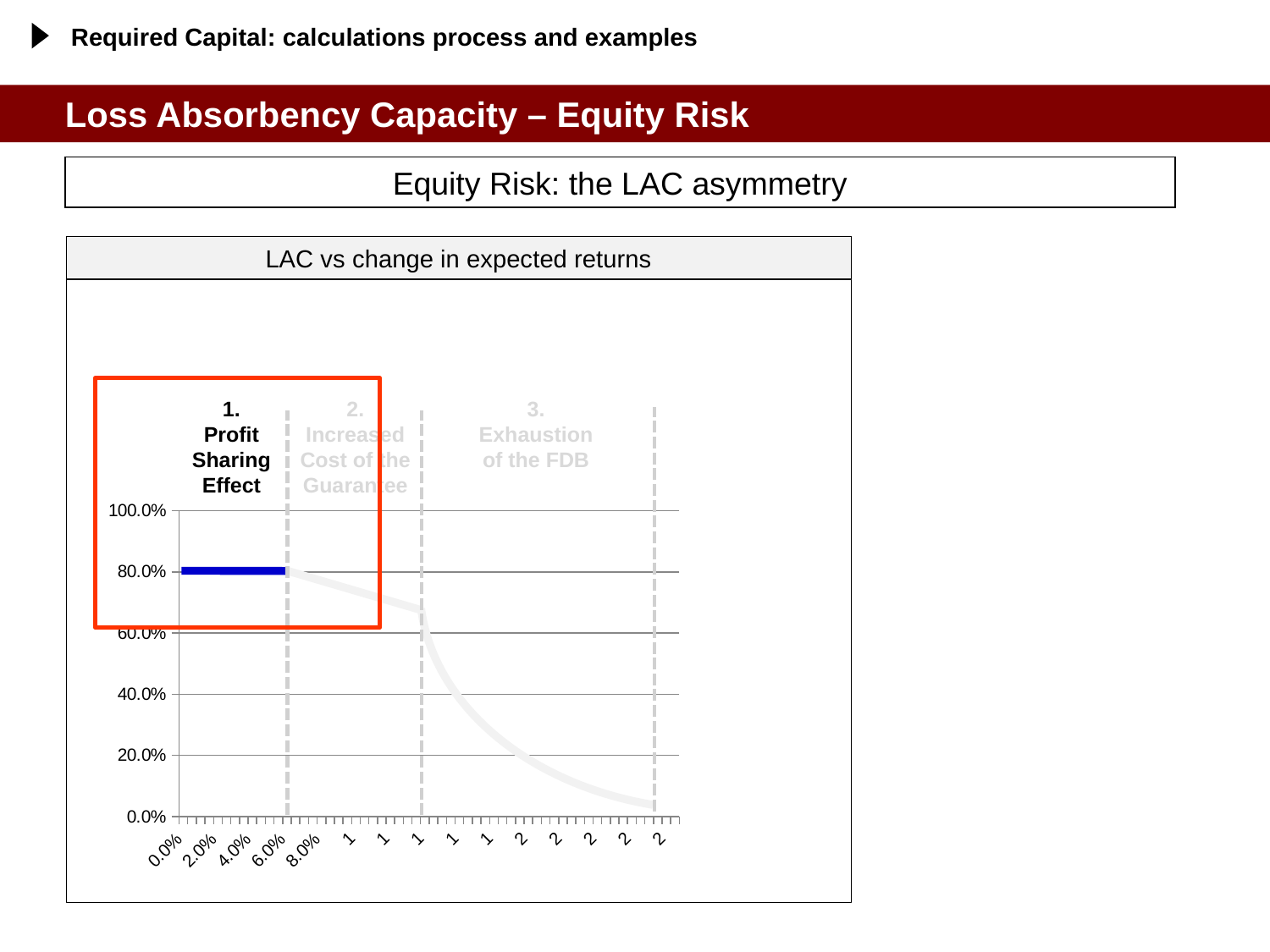
Is the value of the line at 0.0% greater or less than the value at the far right end of the x axis? greater What is the value of the line at 4.0% on the x axis? 80.0% What is the label of the first numbered phase above the chart? Profit Sharing Effect Does the line rise, fall or stay flat between 0.0% and 6.0% on the x axis? stays flat Does the line rise or fall along the x axis after the 6.0% mark? fall Is the value of the line at 2.0% on the x axis greater or less than 60.0%? greater How many numbered phases are labelled above the chart? 3 What is the value of the line at 0.0% on the x axis? 80.0% What is the highest tick value shown on the y axis? 100.0% What kind of chart is shown on the slide? line chart Is the value of the line at the far right end of the x axis greater or less than 20.0%? less What is the title of the chart? LAC vs change in expected returns